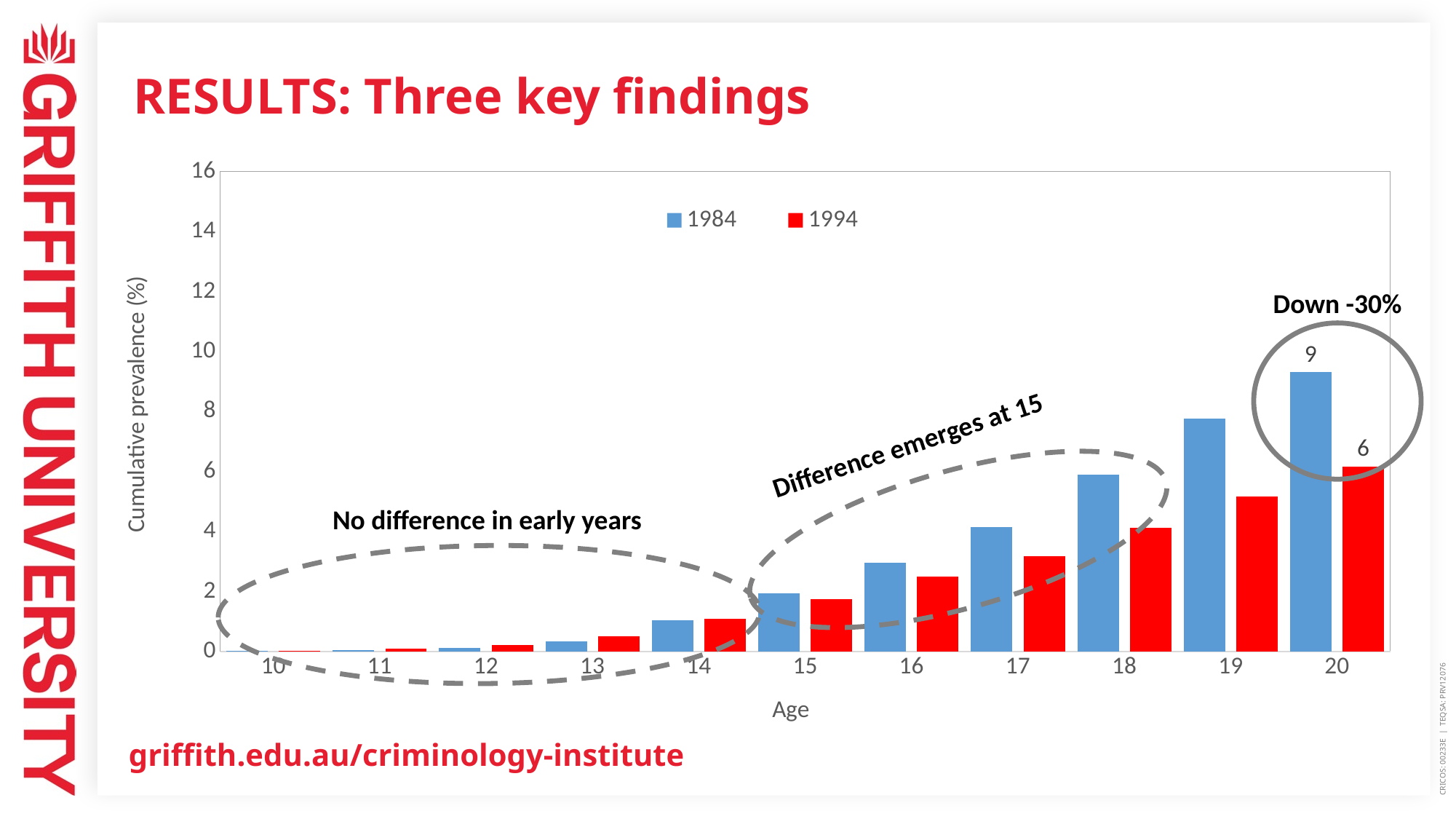
What is the difference between the 1984 and 1994 values at age 20? 3 Do the values for the 1994 series rise or fall as age increases? Rise Is the value for the 1994 series at age 17 greater or less than 4? less How many series does the legend list? 2 How many age categories are shown on the x axis? 11 What is the value for the 1994 series at age 20? 6 Is the value for the 1984 series at age 19 greater or less than 6? greater At age 18, which series has the larger value, 1984 or 1994? 1984 What is the label on the y axis? Cumulative prevalence (%) What kind of chart is shown on the slide? Bar chart What is the value for the 1984 series at age 20? 9 At which age is the 1984 series highest? 20